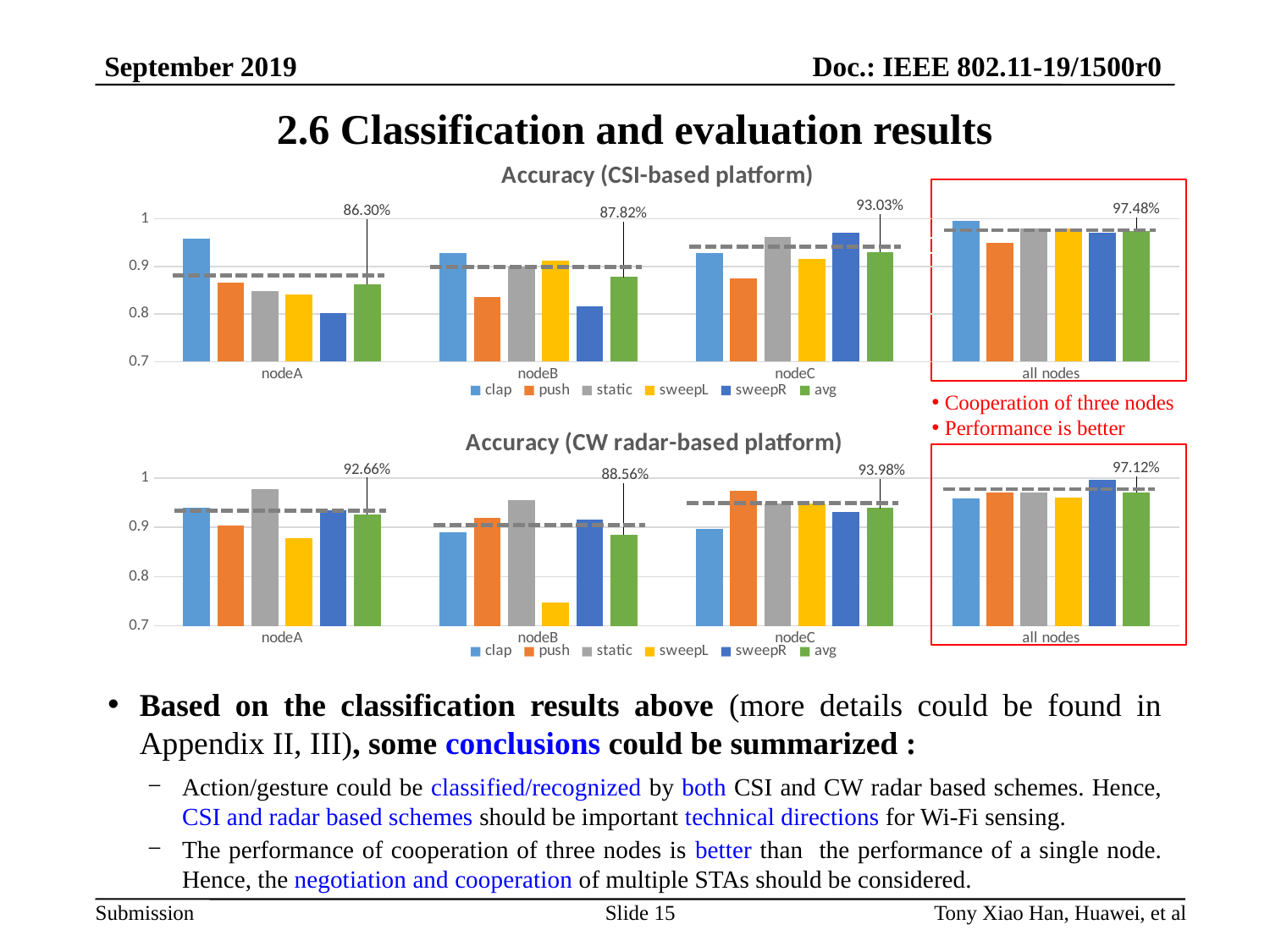
How many series does the legend of the Accuracy (CSI-based platform) chart list? 6 In the Accuracy (CW radar-based platform) chart, which has the larger avg value, nodeA or nodeC? nodeC In the Accuracy (CW radar-based platform) chart, which category has the lowest avg value? nodeB In the Accuracy (CSI-based platform) chart, do the avg values rise or fall from nodeA to all nodes? rise In the Accuracy (CW radar-based platform) chart, what is the avg value for nodeC? 93.98% In the Accuracy (CSI-based platform) chart, what is the difference between the avg value for all nodes and the avg value for nodeA? 11.18% In the Accuracy (CW radar-based platform) chart, what is the avg value for nodeB? 88.56% In the Accuracy (CSI-based platform) chart, what is the avg value for nodeA? 86.30% In the Accuracy (CW radar-based platform) chart, is the sweepL value for nodeB greater or less than 0.8? less In the Accuracy (CSI-based platform) chart, what is the avg value for all nodes? 97.48% In the Accuracy (CSI-based platform) chart, is the sweepR value for nodeA greater or less than 0.9? less In the Accuracy (CSI-based platform) chart, which category has the highest avg value? all nodes